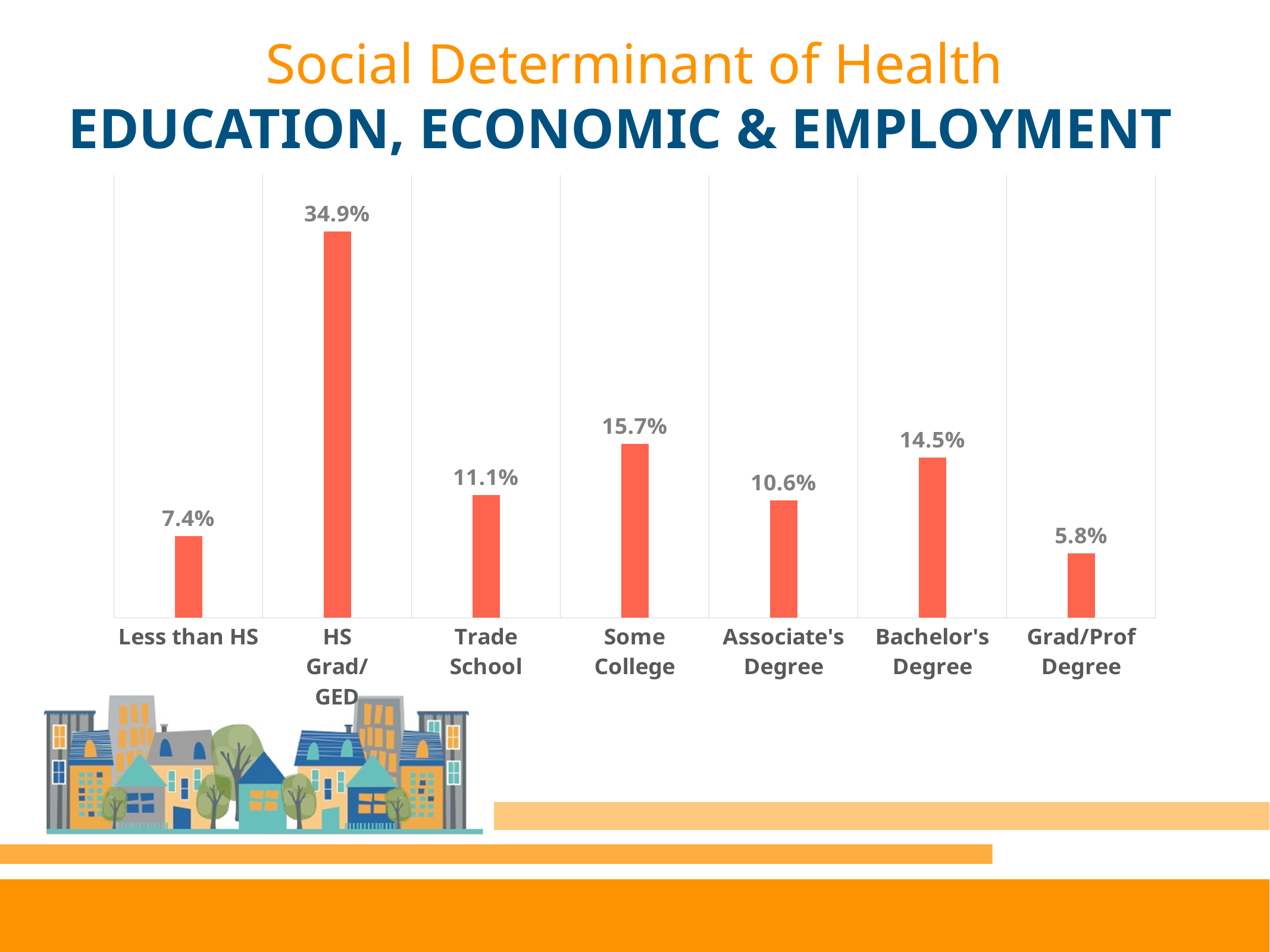
Which category has the lowest value? Grad/Prof Degree Which category has the highest value? HS Grad/GED What is the value for Associate's Degree? 10.6% What is the value for Grad/Prof Degree? 5.8% What is the difference between the values for Some College and Bachelor's Degree? 1.2% What is the value for Some College? 15.7% What is the value for HS Grad/GED? 34.9% What kind of chart is shown on the slide? Bar chart What colour are the bars in the chart? Red How many categories are shown in the chart? 7 What is the difference between the values for HS Grad/GED and Less than HS? 27.5% Which is larger, the value for Trade School or the value for Associate's Degree? Trade School